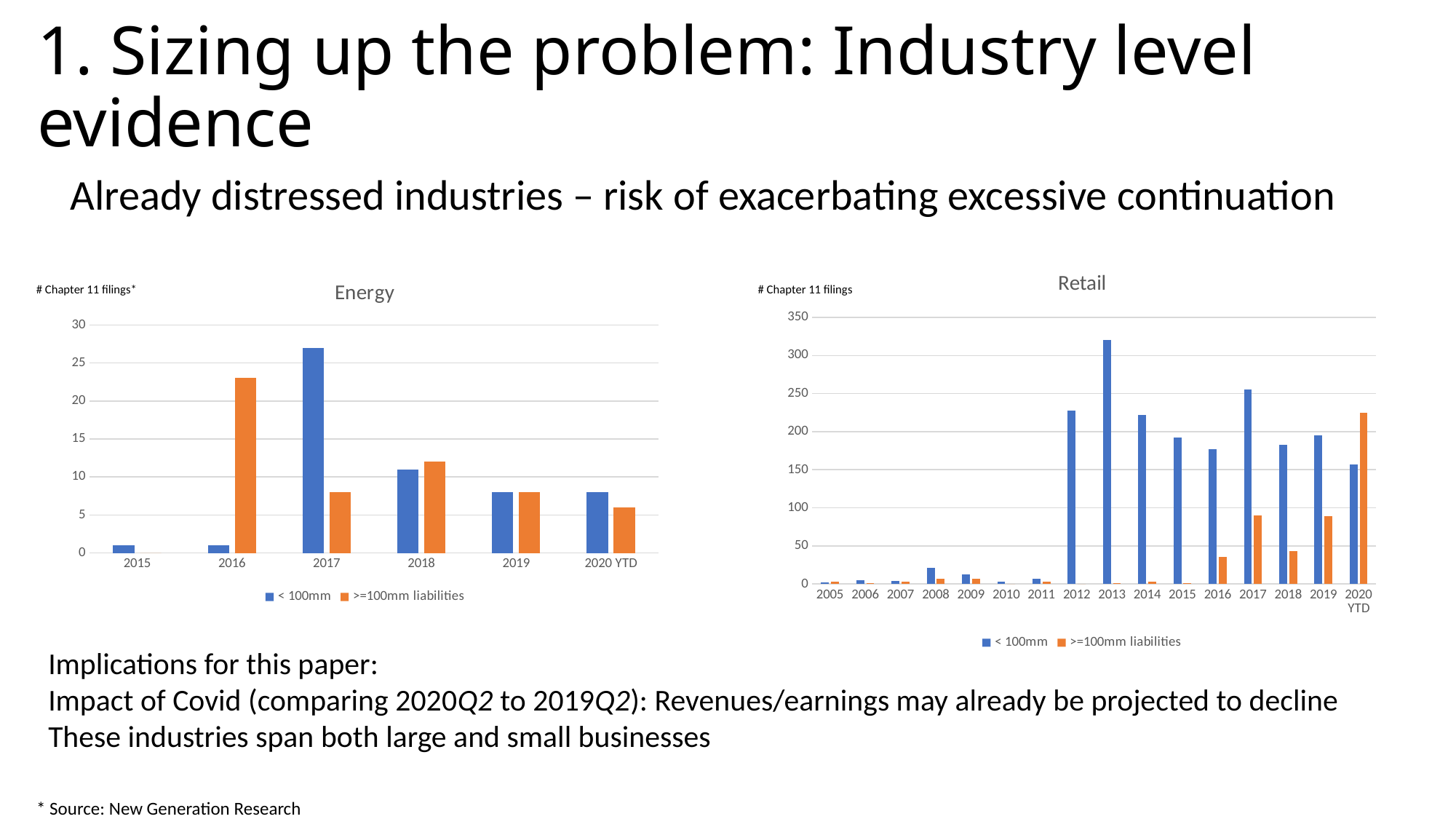
What kind of chart is the Energy chart? bar chart How many series does the legend of the Energy chart list? 2 In the Energy chart, is the value for < 100mm in 2015 greater or less than 5? less How many year categories are shown on the x axis of the Retail chart? 16 In the Energy chart, which series is larger in 2017: < 100mm or >=100mm liabilities? < 100mm What are the two legend entries of the Retail chart? < 100mm and >=100mm liabilities How many year categories are shown on the x axis of the Energy chart? 6 In the Retail chart, which year has the highest value for the < 100mm series? 2013 In the Energy chart, which year has the highest value for the < 100mm series? 2017 In the Energy chart, is the value for >=100mm liabilities in 2016 greater or less than 20? greater In the Retail chart, which series is larger in 2020 YTD: < 100mm or >=100mm liabilities? >=100mm liabilities In the Retail chart, is the value for < 100mm in 2013 greater or less than 300? greater